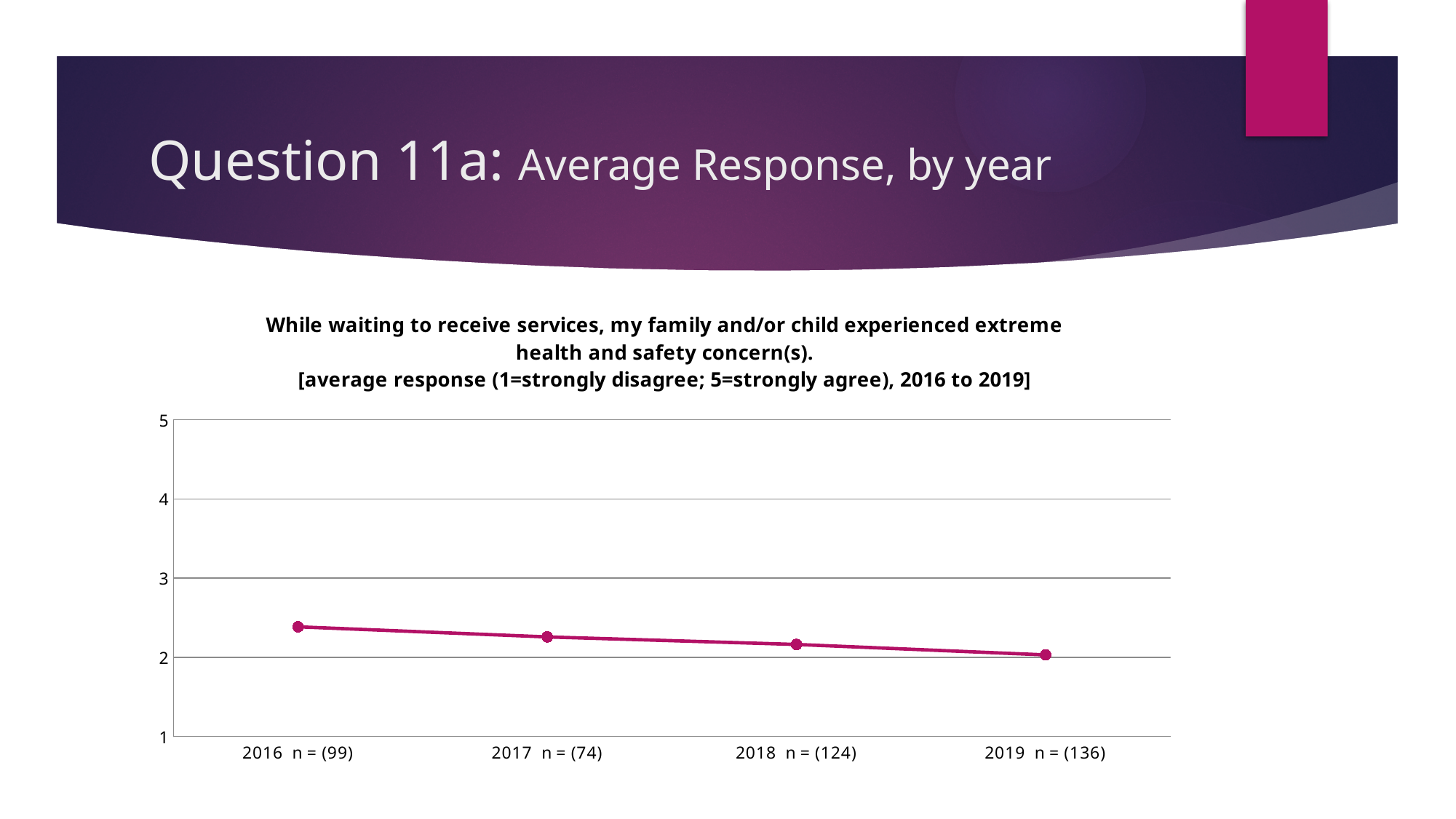
What is the sample size (n) shown for 2019 on the x axis? 136 Which year has the highest average response? 2016 Is the average response for 2016 greater or less than 3? less Which year has the lowest average response? 2019 How many years (data points) are plotted on the chart? 4 Which year has the larger average response, 2016 or 2018? 2016 Is the average response for 2016 greater or less than 2? greater What kind of chart is shown on the slide? line chart What is the sample size (n) shown for 2017 on the x axis? 74 Which year has the larger average response, 2016 or 2019? 2016 Is the average response for 2017 greater or less than 2? greater Do the average responses rise or fall from 2016 to 2019? fall